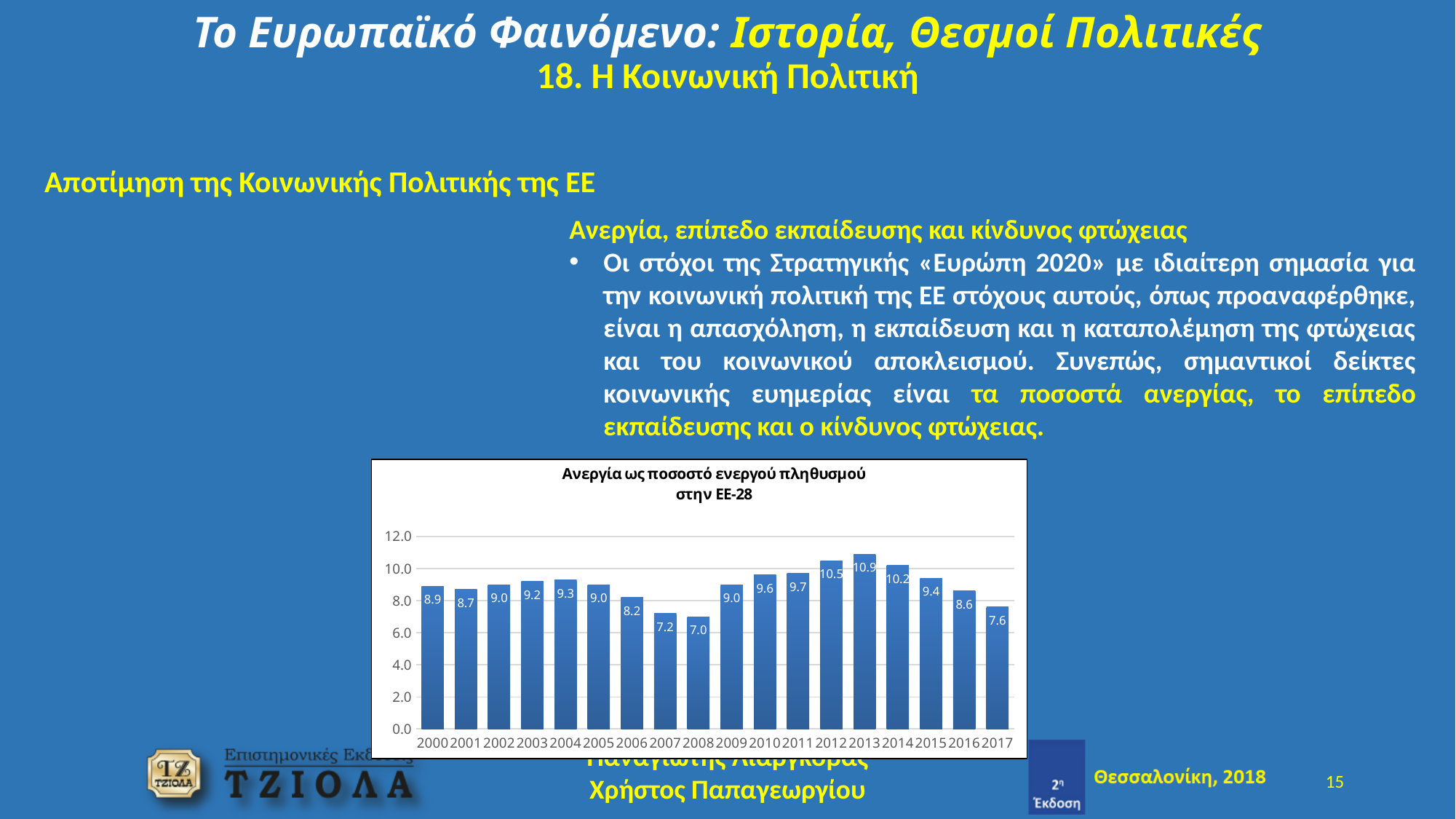
What value is shown for 2008? 7.0 What is the title of the chart? Ανεργία ως ποσοστό ενεργού πληθυσμού στην ΕΕ-28 Which year has the lowest unemployment rate? 2008 Do the values rise or fall from 2014 to 2017? Fall Which year has the highest unemployment rate? 2013 What is the unemployment rate shown for 2013? 10.9 What is the value for 2017? 7.6 What is the difference between the values for 2013 and 2008? 3.9 Is the value for 2011 greater or less than 10.0? less Which year has a higher value, 2012 or 2014? 2012 What kind of chart is shown on the slide? Bar chart How many years are shown on the x axis? 18